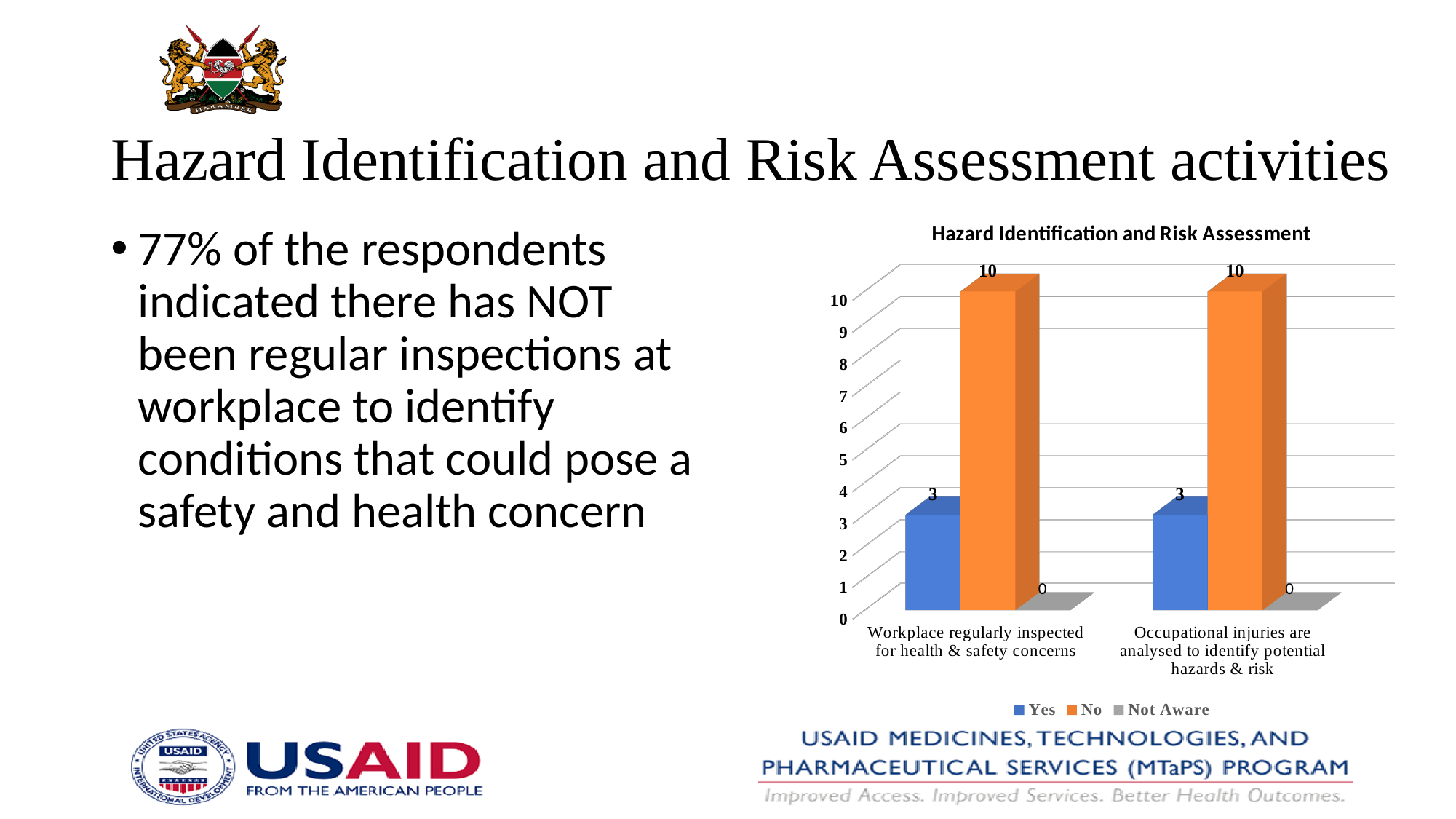
What kind of chart is shown on the slide? Bar chart How many categories are shown on the x axis of the chart? 2 Is the "Yes" value for "Workplace regularly inspected for health & safety concerns" greater or less than 5? less Which series has the highest value in the "Occupational injuries are analysed to identify potential hazards & risk" category? No What is the value for "No" in the "Workplace regularly inspected for health & safety concerns" category? 10 What is the title of the chart? Hazard Identification and Risk Assessment How many series does the chart legend list? 3 Which series has the lowest value in the "Workplace regularly inspected for health & safety concerns" category? Not Aware What is the value for "Not Aware" in the "Workplace regularly inspected for health & safety concerns" category? 0 What is the value for "Yes" in the "Occupational injuries are analysed to identify potential hazards & risk" category? 3 Which is larger for "Occupational injuries are analysed to identify potential hazards & risk": the "Yes" value or the "No" value? No What is the difference between the "No" and "Yes" values for "Workplace regularly inspected for health & safety concerns"? 7